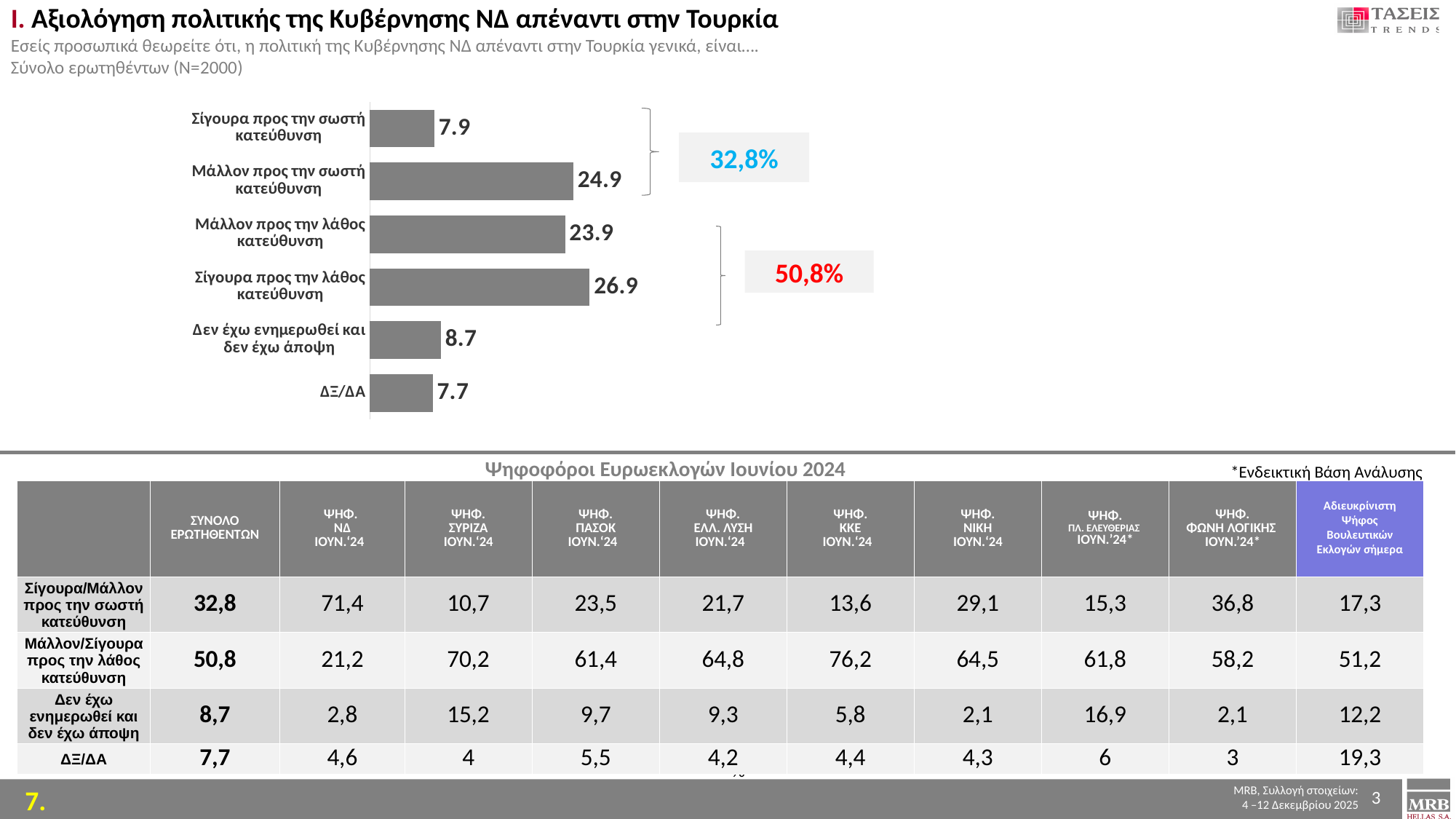
What value is shown for "Μάλλον προς την σωστή κατεύθυνση"? 24.9 What type of chart is shown on the slide? Bar chart What combined percentage is shown in the box next to the two "λάθος κατεύθυνση" bars? 50,8% What combined percentage is shown in the box next to the two "σωστή κατεύθυνση" bars? 32,8% Which category has the highest value in the bar chart? Σίγουρα προς την λάθος κατεύθυνση How many categories are shown in the bar chart? 6 Which is larger: the value for "Μάλλον προς την σωστή κατεύθυνση" or for "Μάλλον προς την λάθος κατεύθυνση"? Μάλλον προς την σωστή κατεύθυνση What value is shown for "Σίγουρα προς την λάθος κατεύθυνση"? 26.9 What is the difference between the values for "Σίγουρα προς την λάθος κατεύθυνση" and "Μάλλον προς την λάθος κατεύθυνση"? 3.0 Which category has the lowest value in the bar chart? ΔΞ/ΔΑ What value is shown for "ΔΞ/ΔΑ"? 7.7 What value is shown for "Σίγουρα προς την σωστή κατεύθυνση"? 7.9